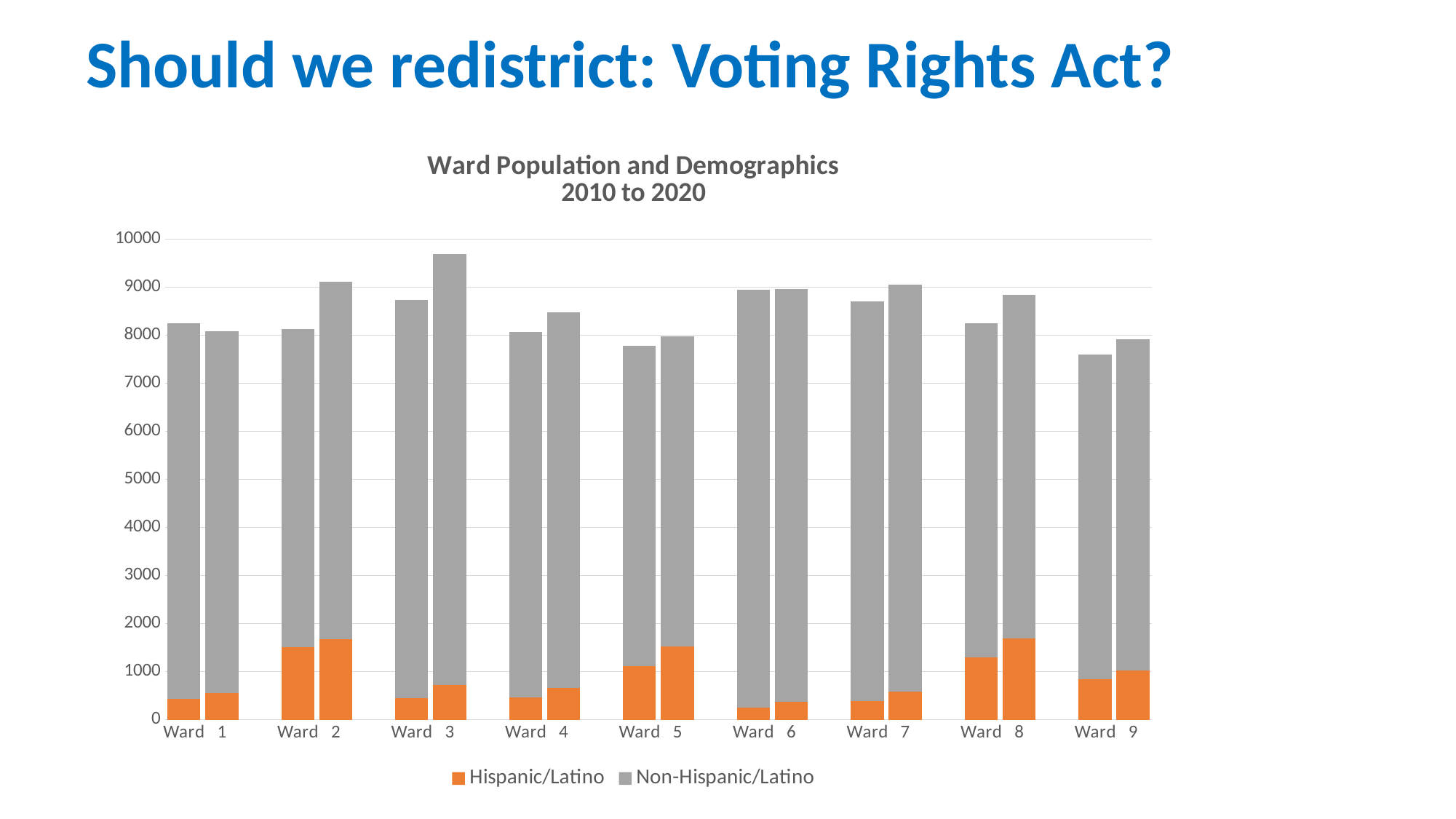
Is the total of the taller bar for Ward 3 greater or less than 9000? greater How many series does the legend list? 2 What is the title of the chart? Ward Population and Demographics 2010 to 2020 What kind of chart is shown on the slide? Stacked bar chart Is the Hispanic/Latino value for the first bar of Ward 6 greater or less than 1000? less Which ward has the tallest total bar? Ward 3 How many wards are shown along the x axis? 9 Is the Hispanic/Latino value for the first bar of Ward 2 greater or less than 1000? greater Which series is shown in orange? Hispanic/Latino Which has the larger Hispanic/Latino segment, the first bar of Ward 2 or the first bar of Ward 6? Ward 2 Which has the larger total, the second bar of Ward 3 or the second bar of Ward 1? Ward 3